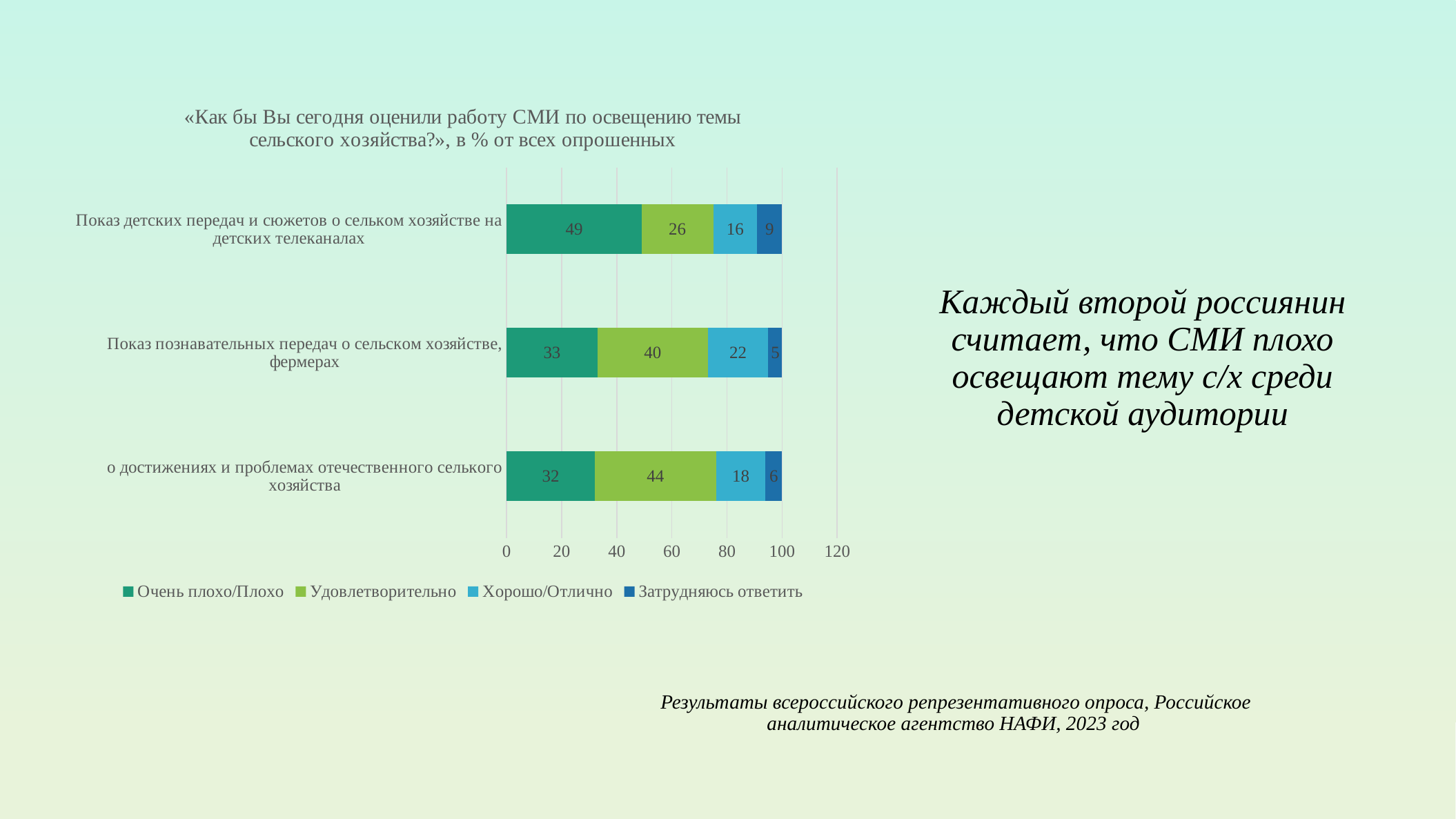
What is the value of «Удовлетворительно» for «о достижениях и проблемах отечественного селького хозяйства»? 44 What type of chart is shown on the slide? Stacked bar chart How many series does the legend list? 4 Which category has the highest value for «Очень плохо/Плохо»? Показ детских передач и сюжетов о сельком хозяйстве на детских телеканалах What is the difference between the «Удовлетворительно» values for «о достижениях и проблемах отечественного селького хозяйства» and «Показ детских передач и сюжетов о сельком хозяйстве на детских телеканалах»? 18 Which category has the lowest value for «Затрудняюсь ответить»? Показ познавательных передач о сельском хозяйстве, фермерах What is the total of the stacked bar for «Показ познавательных передач о сельском хозяйстве, фермерах»? 100 What is the value of «Хорошо/Отлично» for «Показ познавательных передач о сельском хозяйстве, фермерах»? 22 What is the value of «Затрудняюсь ответить» for «Показ детских передач и сюжетов о сельком хозяйстве на детских телеканалах»? 9 What is the value of «Очень плохо/Плохо» for «Показ детских передач и сюжетов о сельком хозяйстве на детских телеканалах»? 49 How many categories (bars) does the chart show? 3 Which is larger: the «Хорошо/Отлично» value for «Показ познавательных передач о сельском хозяйстве, фермерах» or for «о достижениях и проблемах отечественного селького хозяйства»? Показ познавательных передач о сельском хозяйстве, фермерах